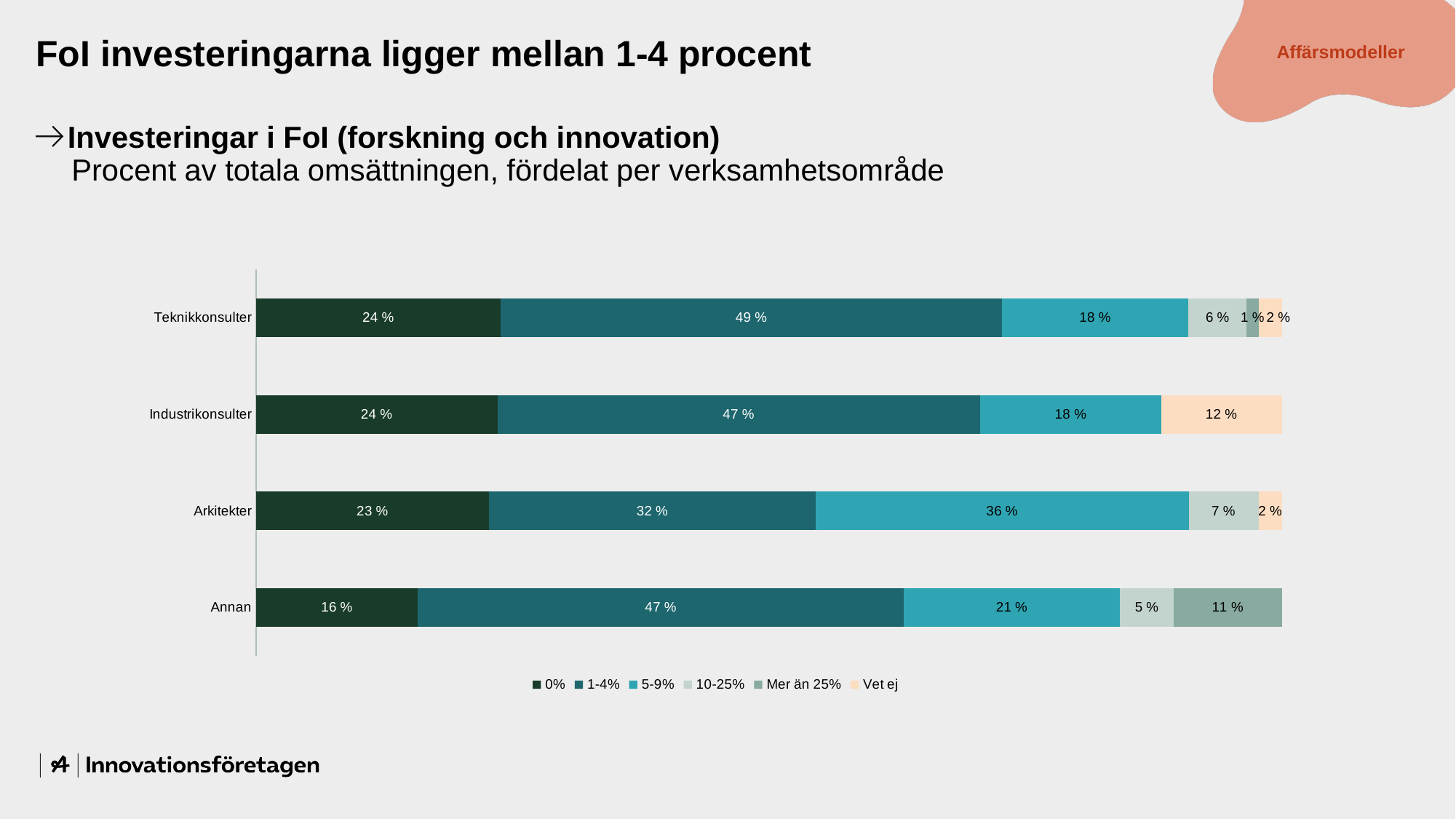
How many series does the legend list? 6 What is the value of the 1-4% segment for Teknikkonsulter? 49 % Which legend entry is shown in the lightest (peach) colour? Vet ej Which category has the lowest value for the 0% segment? Annan What is the difference between the 1-4% segment for Teknikkonsulter and for Arkitekter? 17 % What is the value of the Mer än 25% segment for Annan? 11 % What is the value of the Vet ej segment for Industrikonsulter? 12 % How many categories (verksamhetsområden) are shown on the chart? 4 What is the value of the 5-9% segment for Arkitekter? 36 % Is the 5-9% segment larger for Annan or for Industrikonsulter? Annan What kind of chart is shown on the slide? Stacked bar chart Which category has the highest value for the 5-9% segment? Arkitekter